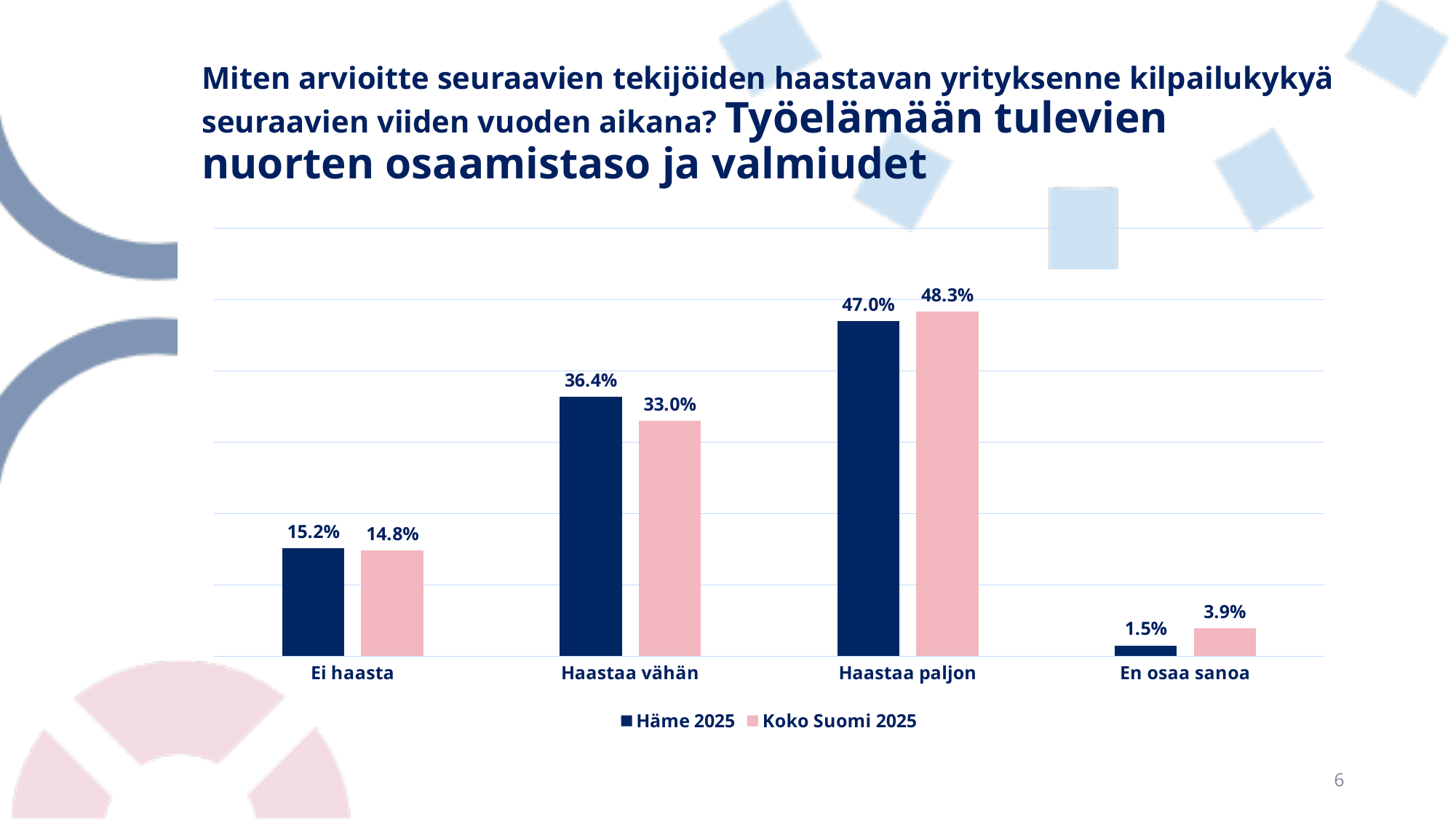
How many categories are shown on the x axis of the chart? 4 Which category has the highest value for Häme 2025? Haastaa paljon What is the value for Häme 2025 in the 'Haastaa paljon' category? 47.0% What is the difference between Häme 2025 and Koko Suomi 2025 in the 'Haastaa vähän' category? 3.4% How many series does the legend list? 2 What is the value for Koko Suomi 2025 in the 'En osaa sanoa' category? 3.9% Which category has the lowest value for Koko Suomi 2025? En osaa sanoa Which series is shown in pink in the chart? Koko Suomi 2025 In the 'Haastaa vähän' category, which series has the larger value, Häme 2025 or Koko Suomi 2025? Häme 2025 In the 'Haastaa paljon' category, which series has the larger value, Häme 2025 or Koko Suomi 2025? Koko Suomi 2025 What kind of chart is shown on the slide? Bar chart What is the value for Koko Suomi 2025 in the 'Ei haasta' category? 14.8%